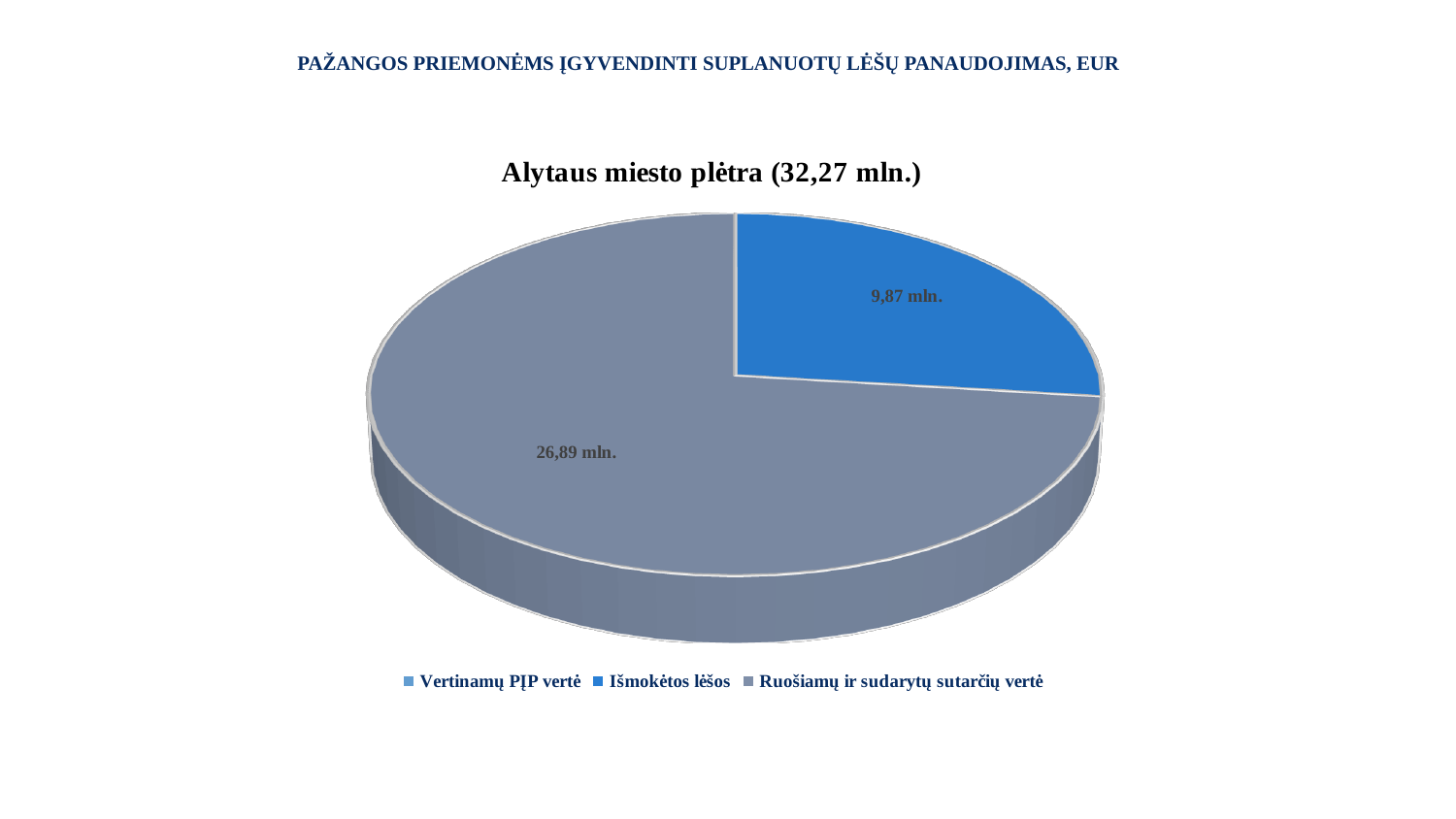
Which slice of the pie chart has the largest value? Ruošiamų ir sudarytų sutarčių vertė (26,89 mln.) Which is larger: the blue slice or the grey slice of the pie chart? the grey slice How many slices of the pie chart carry a data label? 2 Which labelled slice of the pie chart has the smallest value? the blue slice, 9,87 mln. What kind of chart is shown on the slide? pie chart What total amount is given in parentheses in the pie chart's title? 32,27 mln. How many entries does the legend of the pie chart list? 3 What is the value shown on the blue slice of the pie chart? 9,87 mln. What is the value shown on the grey slice (Ruošiamų ir sudarytų sutarčių vertė) of the pie chart? 26,89 mln. What is the title of the pie chart? Alytaus miesto plėtra (32,27 mln.) What is the difference between the grey slice (26,89 mln.) and the blue slice (9,87 mln.)? 17,02 mln.